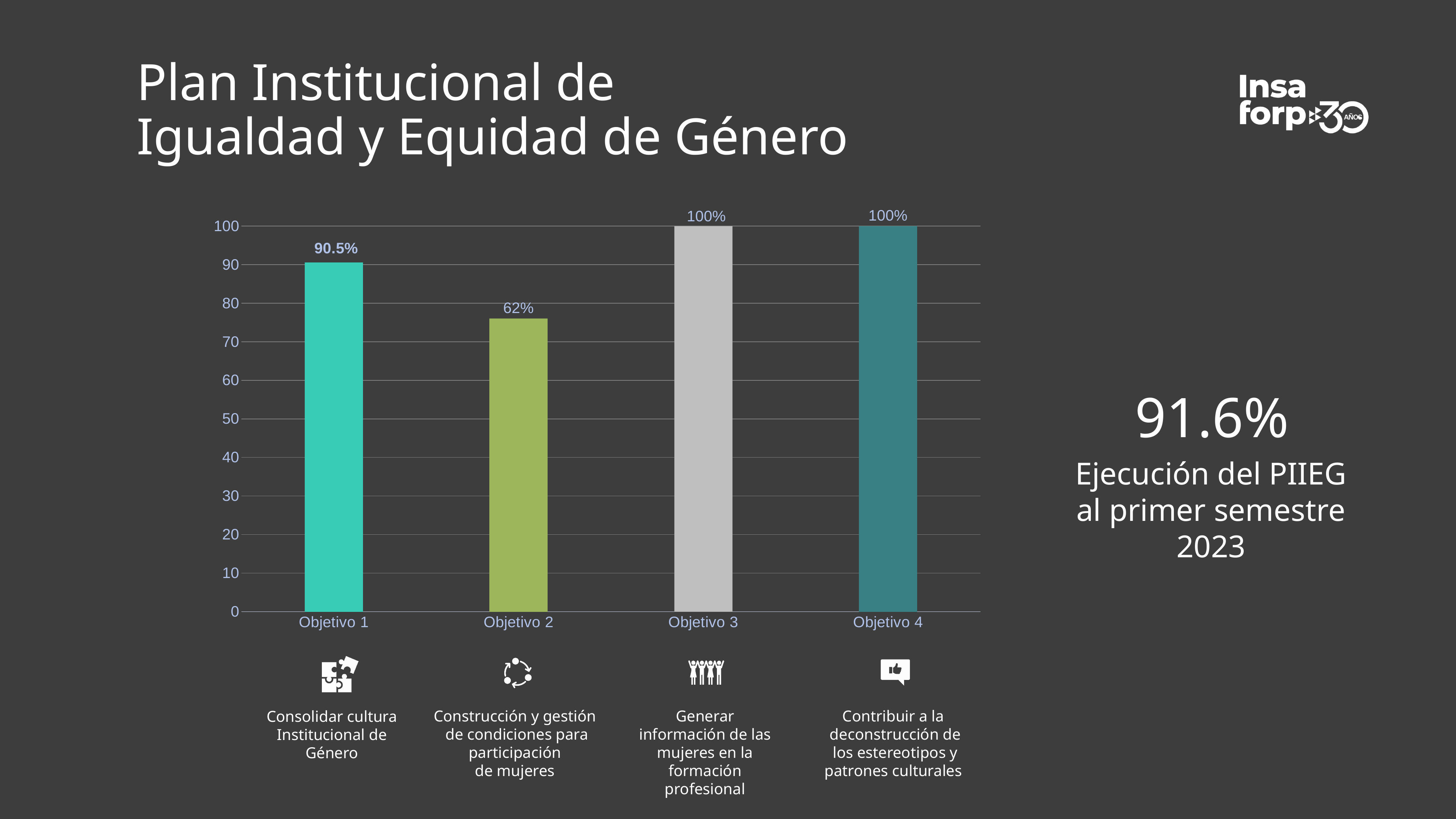
What is the difference between the value for Objetivo 3 and the value for Objetivo 1? 9.5 percentage points What kind of chart is shown on the slide? Bar chart What colour is the bar for Objetivo 1? Turquoise Which objective has the lowest value in the chart? Objetivo 2 What is the value shown for Objetivo 4? 100% Is the value for Objetivo 1 greater or less than 80? greater What is the value shown for Objetivo 1? 90.5% Which is larger, the value for Objetivo 1 or the value for Objetivo 2? Objetivo 1 What is the value shown for Objetivo 2? 62% What is the value shown for Objetivo 3? 100% How many objectives are plotted in the chart? 4 Which objectives share the highest value in the chart? Objetivo 3 and Objetivo 4